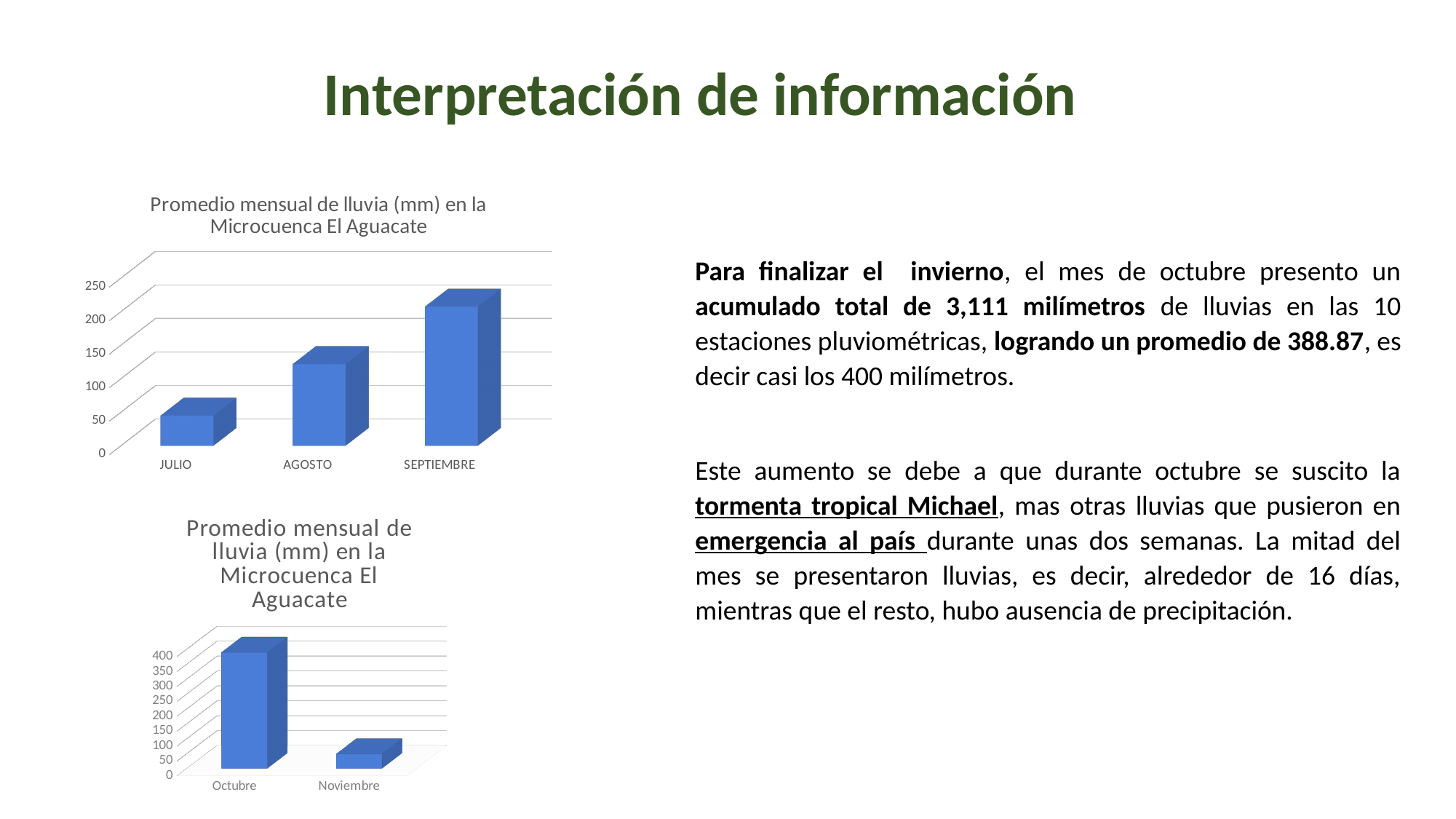
In the top chart, which is larger, the value for AGOSTO or the value for JULIO? AGOSTO In the bottom chart, which month has the higher average rainfall, Octubre or Noviembre? Octubre What kind of chart is the top chart on the slide? Bar chart In the top chart, is the value for SEPTIEMBRE greater or less than 150? greater In the bottom chart, is the value for Noviembre greater or less than 100? less How many months are shown in the top chart? 3 What is the title of the bottom chart? Promedio mensual de lluvia (mm) en la Microcuenca El Aguacate In the top chart, do the values rise or fall from JULIO to SEPTIEMBRE? Rise In the bottom chart, is the value for Octubre greater or less than 300? greater In the top chart, which month has the lowest average rainfall? JULIO In the top chart, which month has the highest average rainfall? SEPTIEMBRE